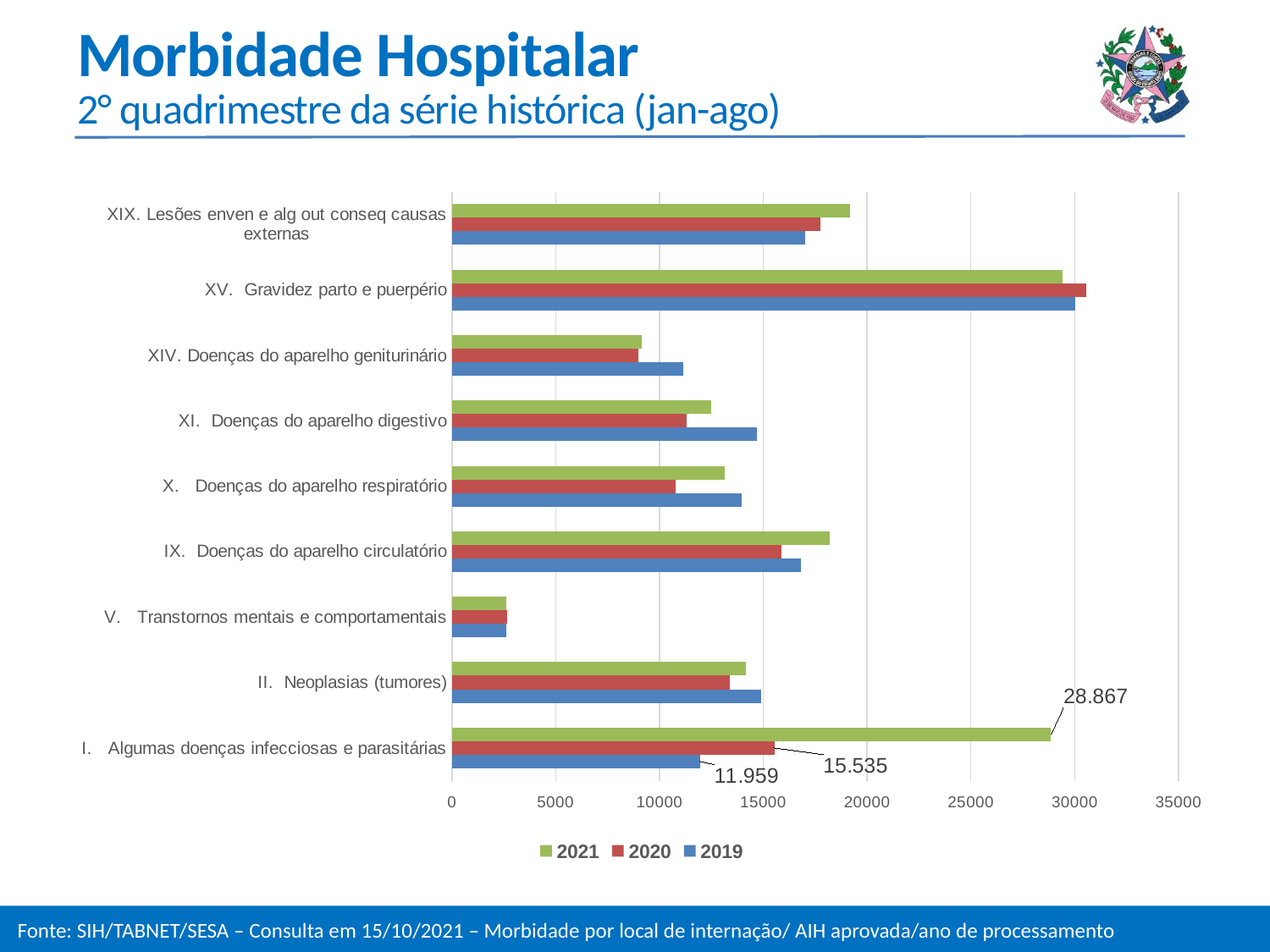
What is the 2019 value for 'I. Algumas doenças infecciosas e parasitárias'? 11.959 What is the 2020 value for 'I. Algumas doenças infecciosas e parasitárias'? 15.535 How many series does the legend list? 3 What kind of chart is shown on the slide? Bar chart For 'I. Algumas doenças infecciosas e parasitárias', what is the difference between the 2021 and 2020 values? 13.332 Which category has the lowest values across all three years? V. Transtornos mentais e comportamentais For 'I. Algumas doenças infecciosas e parasitárias', which year has the larger value, 2021 or 2019? 2021 Which category has the highest 2019 value? XV. Gravidez parto e puerpério Is the 2020 value for 'XIV. Doenças do aparelho geniturinário' greater or less than 10000? less Is the 2019 value for 'XV. Gravidez parto e puerpério' greater or less than 25000? greater What is the 2021 value for 'I. Algumas doenças infecciosas e parasitárias'? 28.867 How many categories are shown on the chart? 9